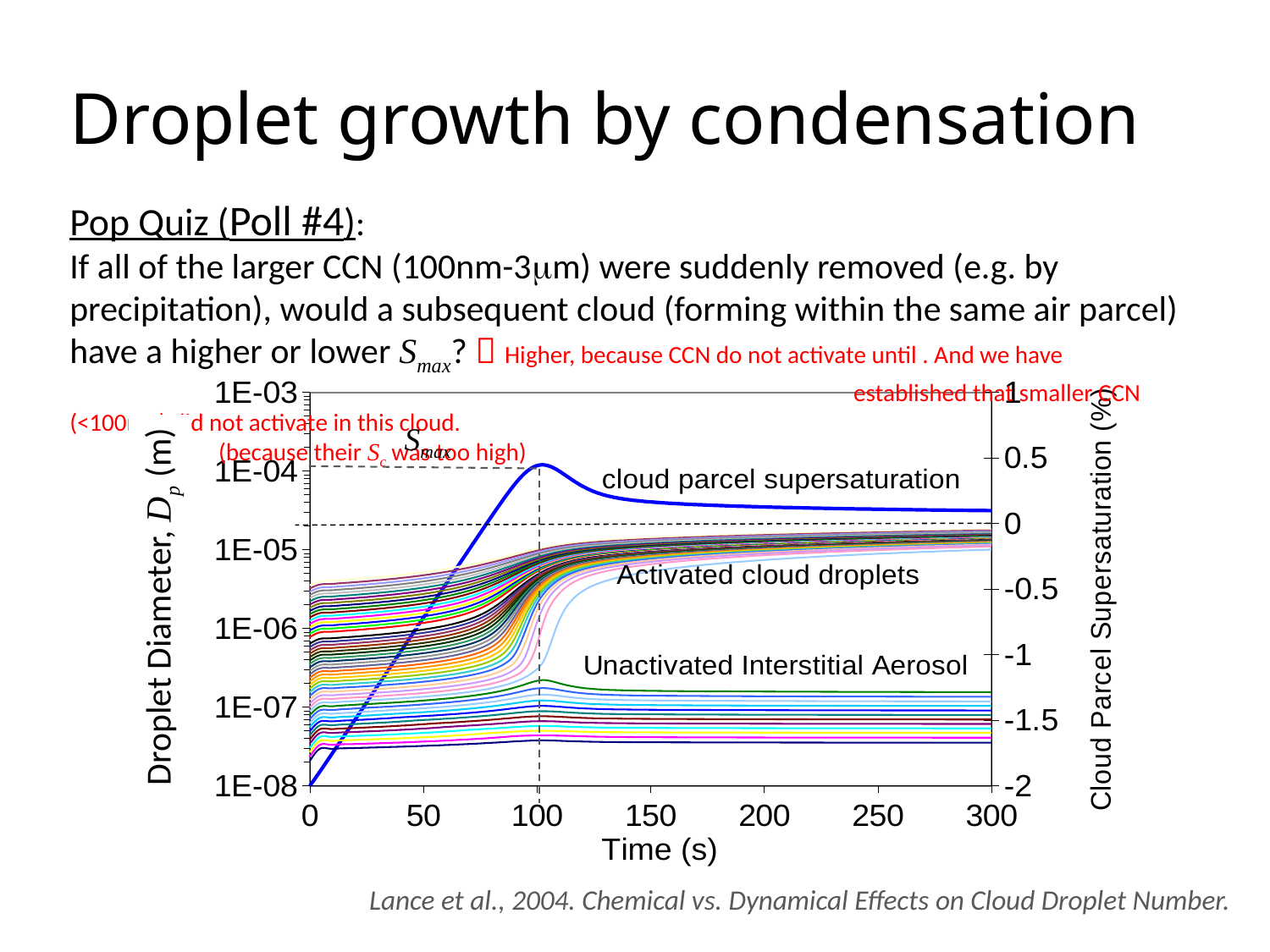
What is the lowest value labelled on the right y axis (Cloud Parcel Supersaturation)? -2 At what time (s) does the cloud parcel supersaturation reach its maximum, Smax, according to the dashed vertical line? 100 What is the highest value labelled on the left y axis (Droplet Diameter)? 1E-03 What is the label of the right-hand y axis of the chart? Cloud Parcel Supersaturation (%) Is the cloud parcel supersaturation at 0 s greater or less than -1? less How many tick marks are labelled on the x axis of the chart? 7 Is the peak cloud parcel supersaturation greater or less than 1? less What kind of chart is shown on the slide? line chart Does the cloud parcel supersaturation rise or fall between 0 s and 100 s? rise What is the label of the x axis of the chart? Time (s) Does the cloud parcel supersaturation rise or fall between 100 s and 300 s? fall Is the cloud parcel supersaturation at 300 s greater or less than 0? greater